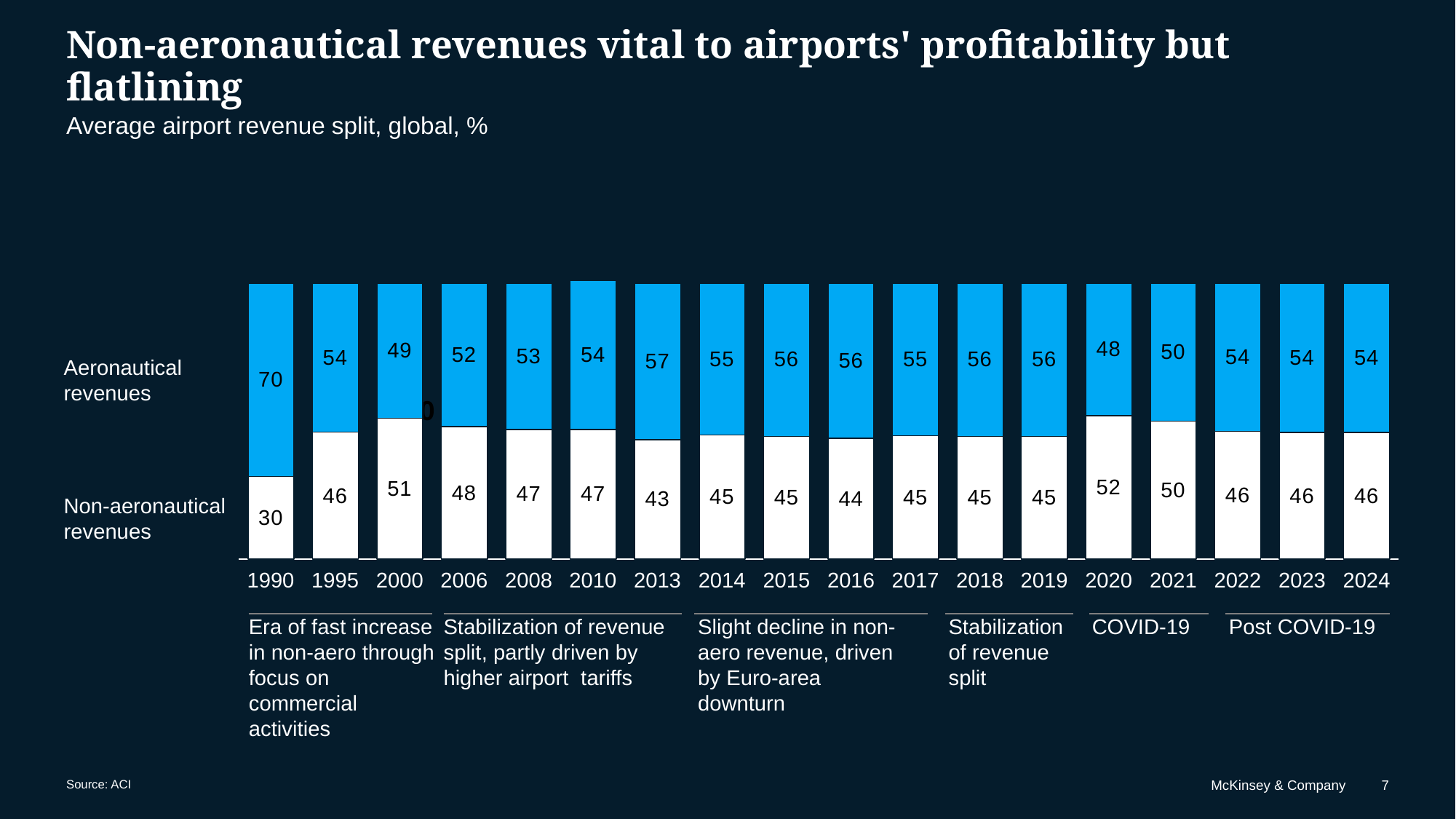
What is the non-aeronautical revenues value for 1990? 30 What kind of chart is shown on the slide? Stacked bar chart What is the aeronautical revenues value for 2024? 54 Which year has the lowest non-aeronautical revenues share? 1990 What is the subtitle describing the chart's measure? Average airport revenue split, global, % Which year has the highest aeronautical revenues share? 1990 Is the non-aeronautical revenues value larger in 2000 or in 2013? 2000 What is the total of the stacked bar for 2021? 100 What is the non-aeronautical revenues value for 2020? 52 What is the aeronautical revenues value for 2013? 57 What is the difference between the aeronautical and non-aeronautical revenues values in 1990? 40 How many years are shown on the x axis? 18